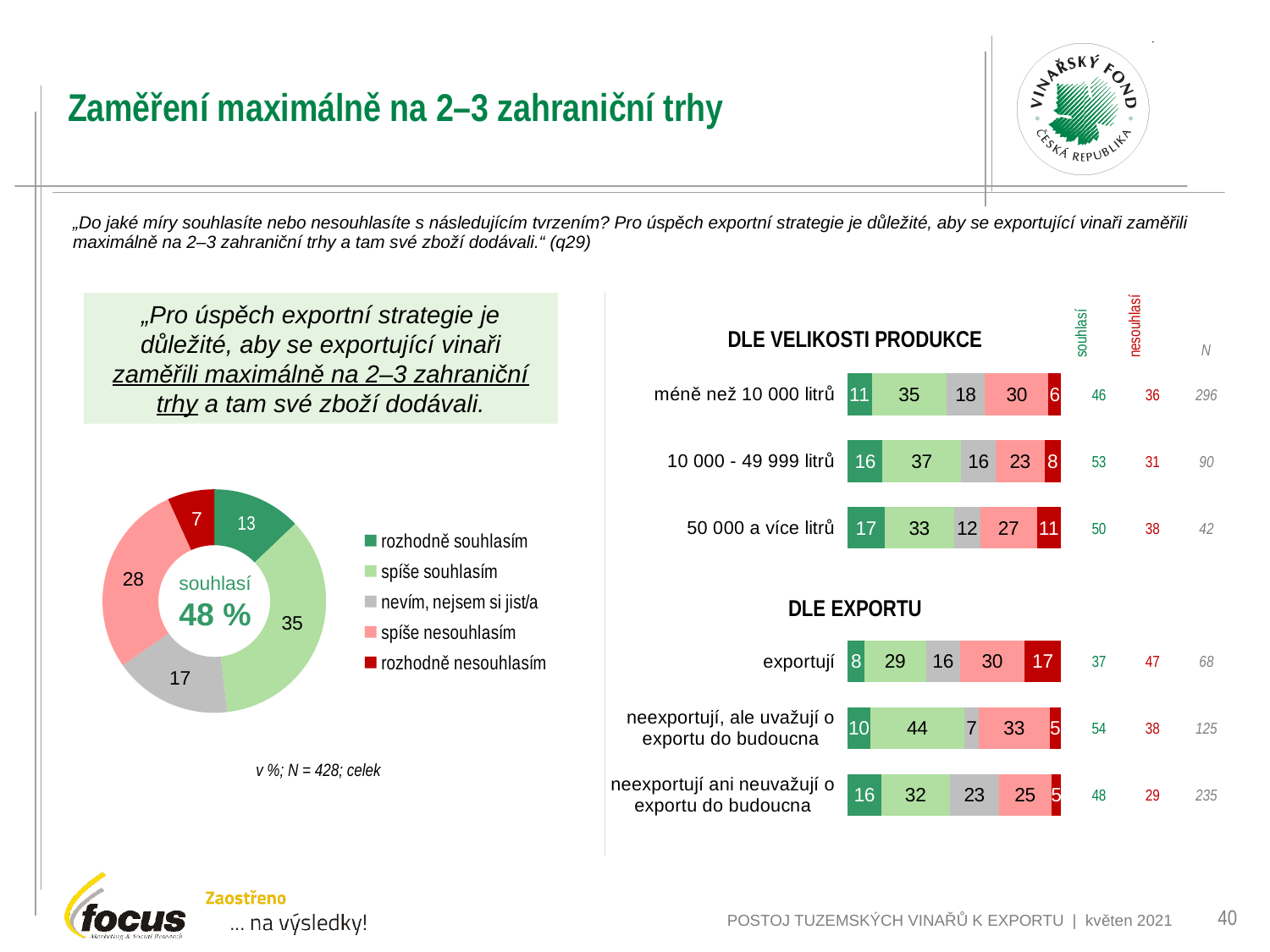
What type of chart is used on the left side of the slide? donut (pie) chart In the "DLE EXPORTU" chart, what is the "rozhodně nesouhlasím" value for "exportují"? 17 In the donut chart on the left, what is the combined share shown in the centre for "souhlasí"? 48 % In the donut chart on the left, what percentage of respondents answered "spíše souhlasím"? 35 In the donut chart on the left, which response category has the smallest share? rozhodně nesouhlasím In the donut chart on the left, which response category has the largest share? spíše souhlasím In the "DLE VELIKOSTI PRODUKCE" chart, what is the "spíše souhlasím" value for "10 000 - 49 999 litrů"? 37 How many entries does the legend of the donut chart on the left list? 5 In the "DLE EXPORTU" chart, is the "spíše souhlasím" value larger for "exportují" or for "neexportují, ale uvažují o exportu do budoucna"? neexportují, ale uvažují o exportu do budoucna In the "DLE EXPORTU" chart, which group has the highest "nevím, nejsem si jist/a" value? neexportují ani neuvažují o exportu do budoucna In the "DLE VELIKOSTI PRODUKCE" chart, how many production-size categories are shown? 3 In the "DLE VELIKOSTI PRODUKCE" chart, what is the difference between the "rozhodně nesouhlasím" values for "50 000 a více litrů" and "méně než 10 000 litrů"? 5